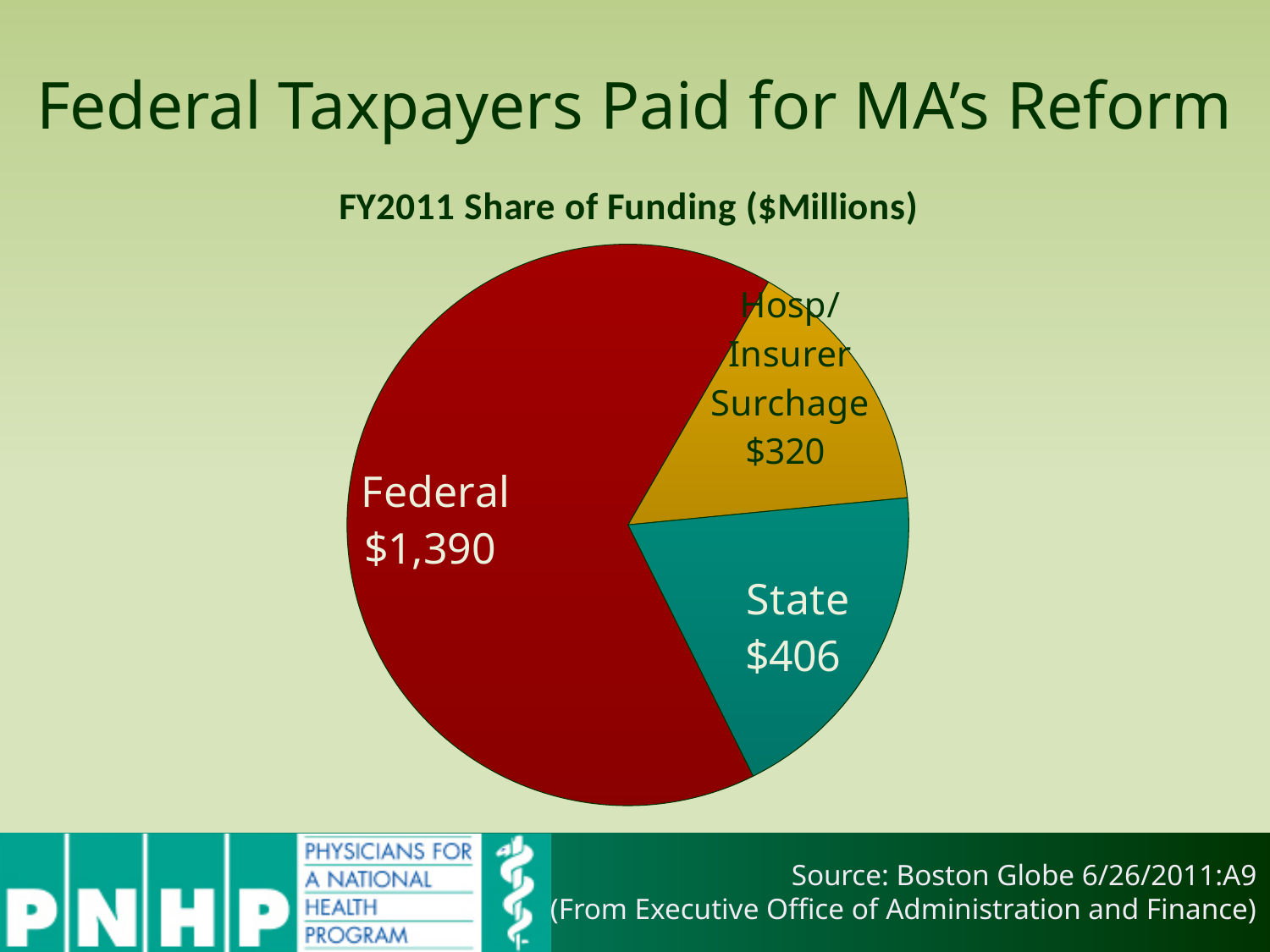
Which slice of the pie chart is the smallest? Hosp/Insurer Surchage What is the total of all three slices in the pie chart? $2,116 How many slices does the pie chart have? 3 What is the value for Hosp/Insurer Surchage in the pie chart? $320 What is the value for Federal in the pie chart? $1,390 What type of chart is shown on the slide? Pie chart Which slice of the pie chart is the largest? Federal What is the title of the pie chart? FY2011 Share of Funding ($Millions) Which is larger, the State value or the Hosp/Insurer Surchage value? State What is the difference between the Federal value and the State value? $984 What is the value for State in the pie chart? $406 What is the difference between the State value and the Hosp/Insurer Surchage value? $86